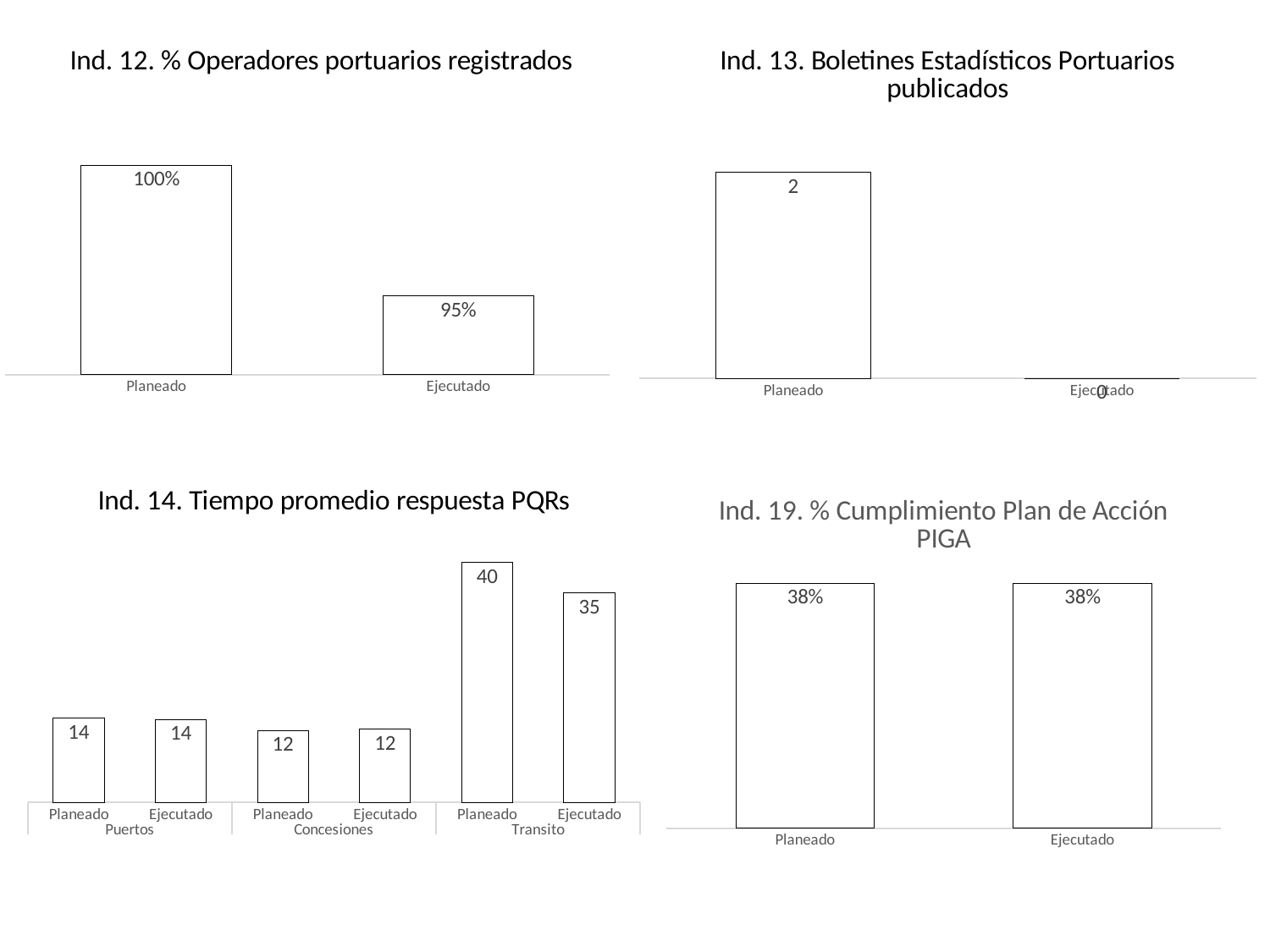
In the chart 'Ind. 14. Tiempo promedio respuesta PQRs', what is the Ejecutado value for Transito? 35 In the chart 'Ind. 14. Tiempo promedio respuesta PQRs', which group has the lowest Planeado value? Concesiones In the chart 'Ind. 14. Tiempo promedio respuesta PQRs', which group has the highest Planeado value? Transito In the chart 'Ind. 14. Tiempo promedio respuesta PQRs', how many bars are plotted? 6 In the chart 'Ind. 14. Tiempo promedio respuesta PQRs', what is the difference between Planeado and Ejecutado for Transito? 5 In the chart 'Ind. 13. Boletines Estadísticos Portuarios publicados', what is the value for Planeado? 2 What kind of chart is 'Ind. 19. % Cumplimiento Plan de Acción PIGA'? Bar chart In the chart 'Ind. 19. % Cumplimiento Plan de Acción PIGA', what is the value for Ejecutado? 38% In the chart 'Ind. 12. % Operadores portuarios registrados', what is the value for Ejecutado? 95% In the chart 'Ind. 12. % Operadores portuarios registrados', which is larger, Planeado or Ejecutado? Planeado In the chart 'Ind. 12. % Operadores portuarios registrados', what is the difference between Planeado and Ejecutado? 5% In the chart 'Ind. 13. Boletines Estadísticos Portuarios publicados', what is the value for Ejecutado? 0